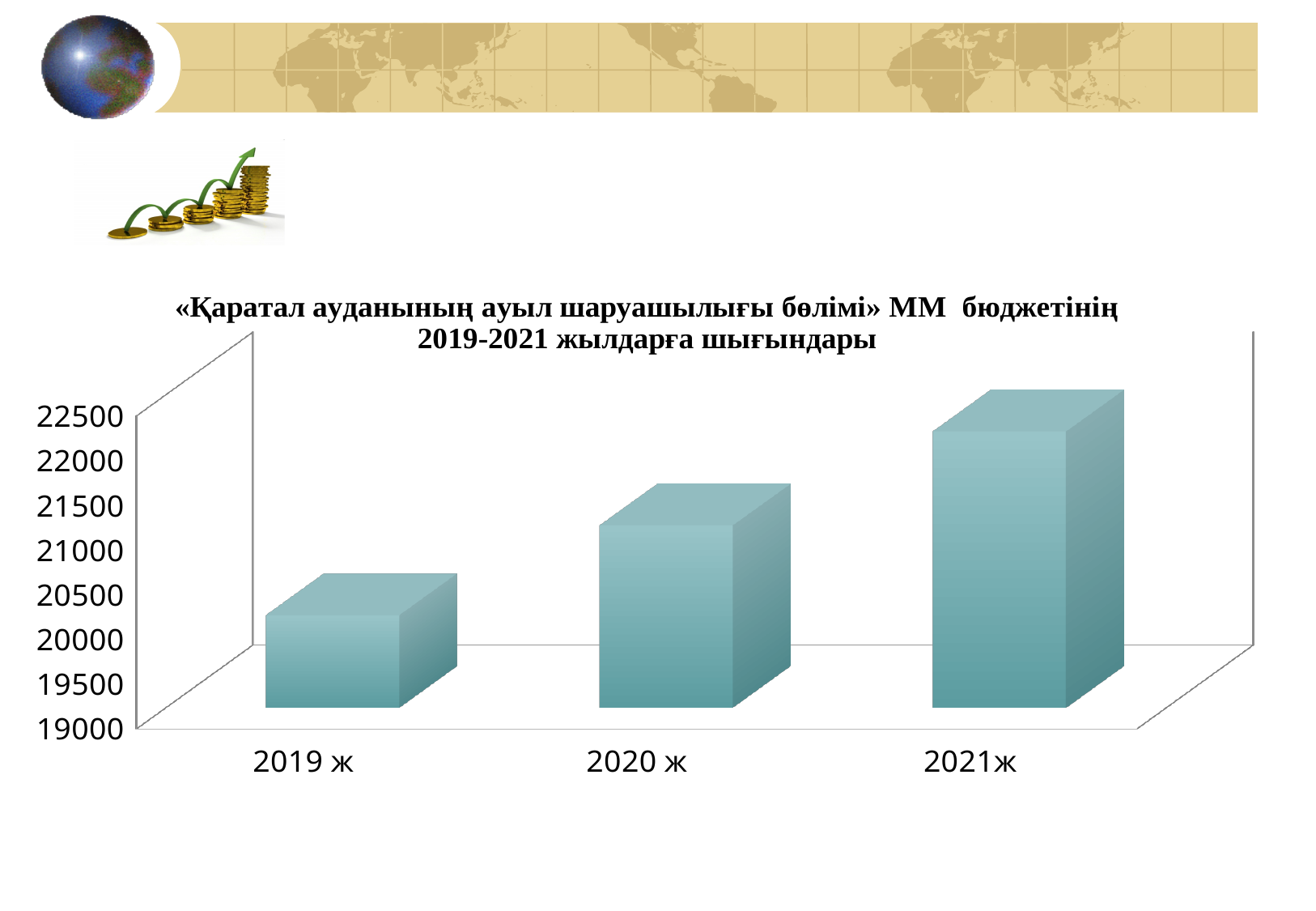
Is the value for 2019 ж greater or less than 19500? greater Which year has the highest value in the chart? 2021ж Is the value for 2021ж greater or less than 21000? greater Do the values rise or fall from 2019 ж to 2021ж? rise Is the value for 2019 ж greater or less than 21000? less Which is larger, the value for 2021ж or the value for 2020 ж? 2021ж What kind of chart is shown on the slide? bar chart Which is larger, the value for 2020 ж or the value for 2019 ж? 2020 ж How many bars (years) are plotted in the chart? 3 What is the title of the chart? «Қаратал ауданының ауыл шаруашылығы бөлімі» ММ бюджетінің 2019-2021 жылдарға шығындары Which year has the lowest value in the chart? 2019 ж